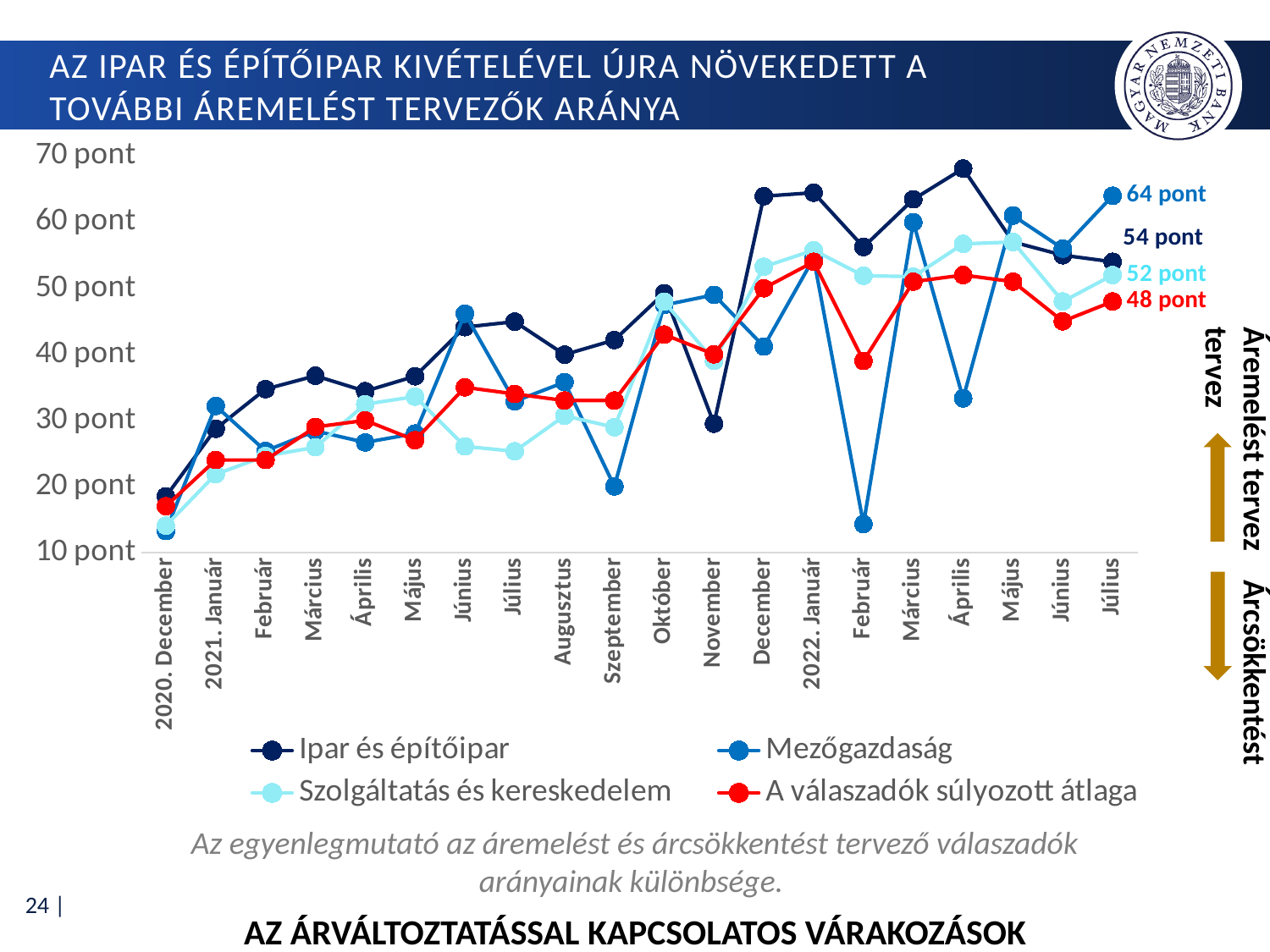
What is the value for A válaszadók súlyozott átlaga in Július 2022? 48 pont Is the value for Mezőgazdaság in Február 2022 greater or less than 20 pont? less Is the value for Ipar és építőipar in Április 2022 greater or less than 60 pont? greater What is the value for Ipar és építőipar in Július 2022? 54 pont What is the difference between the Mezőgazdaság and A válaszadók súlyozott átlaga values in Július 2022? 16 pont In Július 2022, which is larger: Ipar és építőipar or Szolgáltatás és kereskedelem? Ipar és építőipar What is the value for Szolgáltatás és kereskedelem in Július 2022? 52 pont How many months are shown on the x axis? 20 Which series has the highest value in Július 2022? Mezőgazdaság How many series does the legend list? 4 What kind of chart is shown on the slide? line chart What is the value for Mezőgazdaság in Július 2022? 64 pont